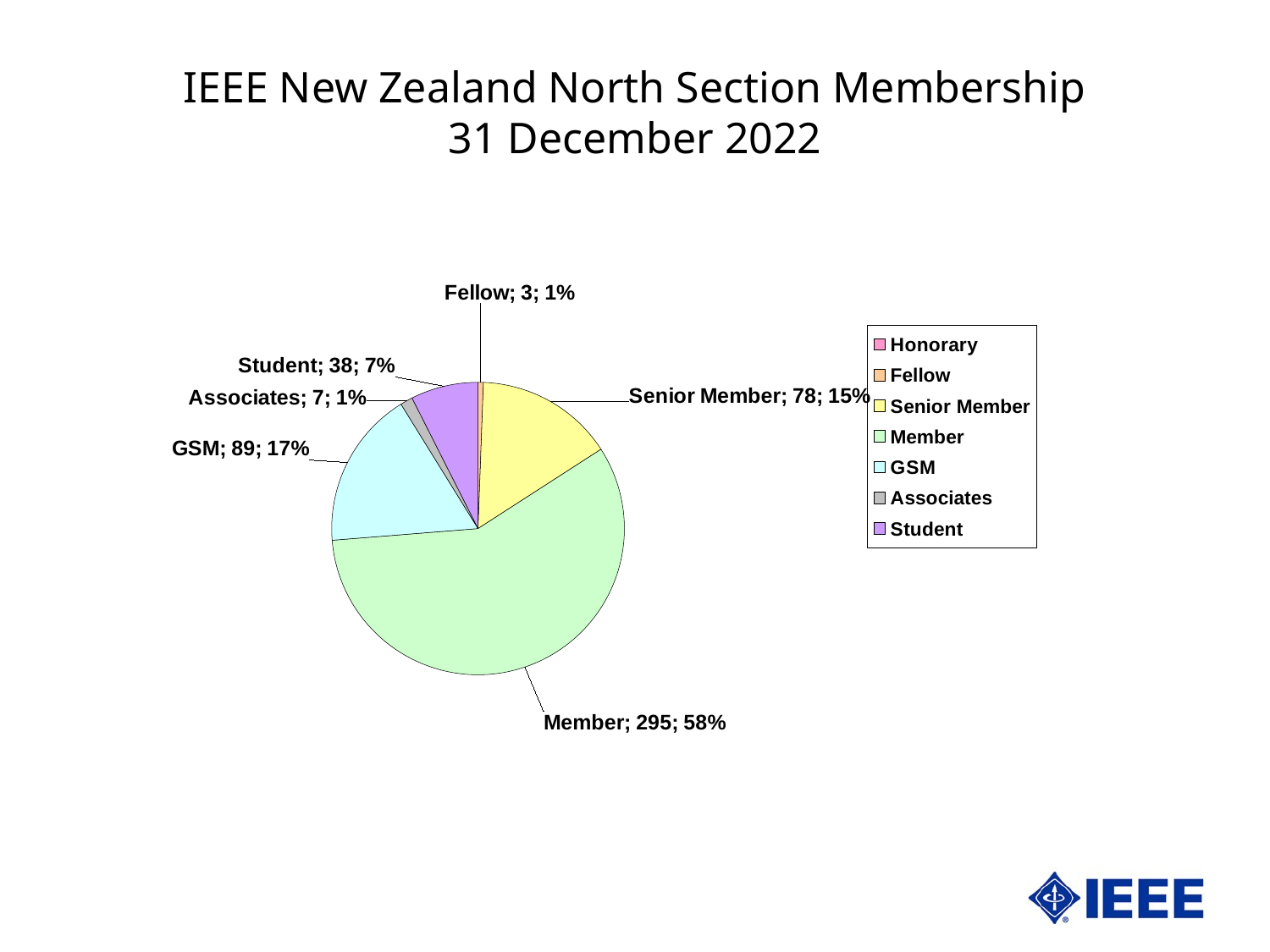
How many members are in the Member category? 295 How many Senior Members are shown? 78 What percentage of the membership is GSM? 17% What is the difference between the number of GSM members and the number of Senior Members? 11 What is the title of the slide containing the chart? IEEE New Zealand North Section Membership 31 December 2022 What is the difference between the Member count and the GSM count? 206 How many Fellows are shown on the chart? 3 Which is larger, the Student count or the Associates count? Student Which category has the largest slice of the pie? Member How many entries does the legend list? 7 What kind of chart is shown on the slide? pie chart What share of the pie does the Student slice represent? 7%